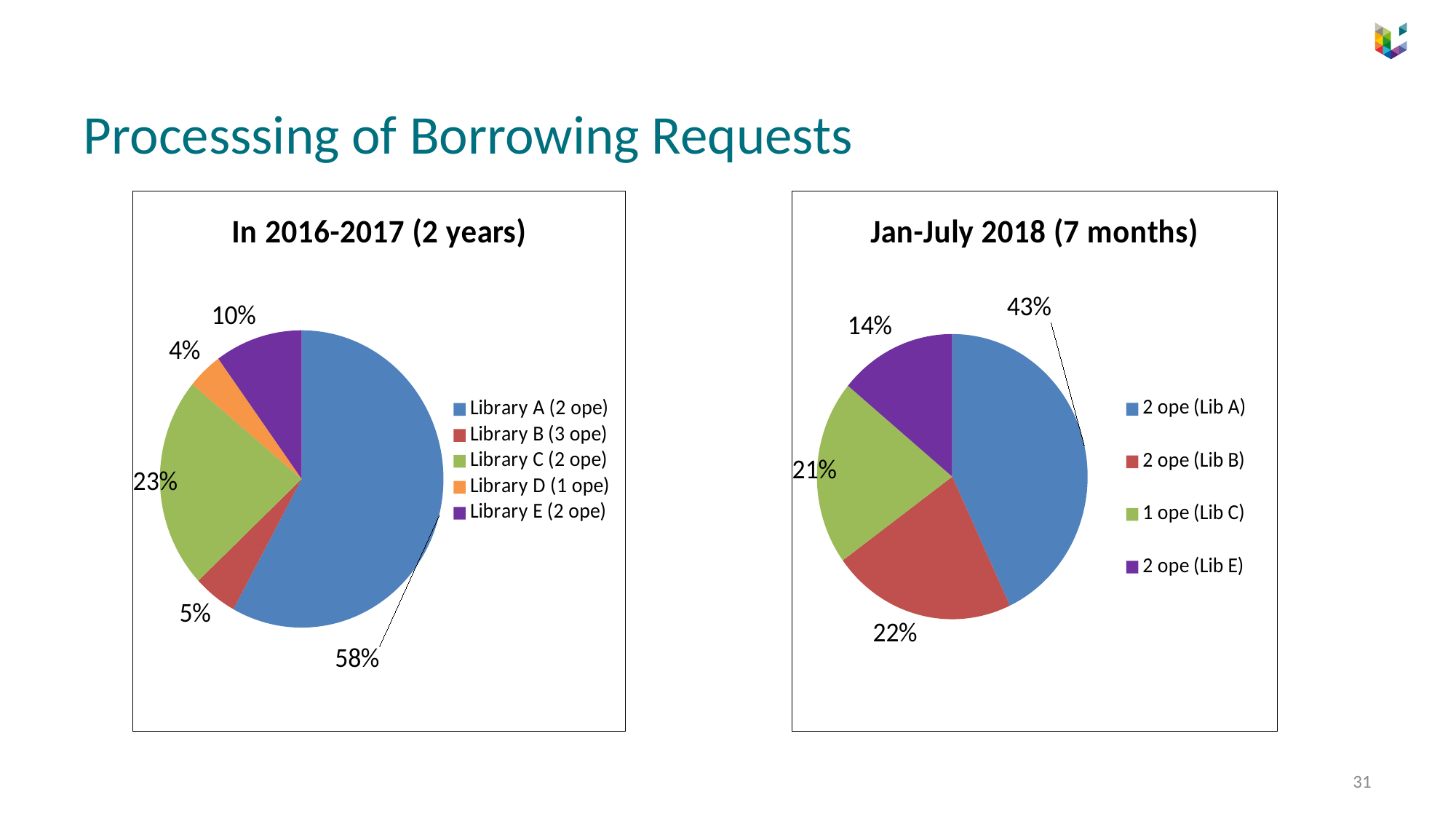
In the 'In 2016-2017 (2 years)' chart, how many slices does the pie have? 5 In the 'In 2016-2017 (2 years)' chart, what colour is the slice for Library D (1 ope)? Orange In the 'Jan-July 2018 (7 months)' chart, which is larger, the share for 2 ope (Lib B) or the share for 2 ope (Lib E)? 2 ope (Lib B) In the 'In 2016-2017 (2 years)' chart, what share does Library A (2 ope) have? 58% In the 'In 2016-2017 (2 years)' chart, which library has the largest slice? Library A (2 ope) In the 'Jan-July 2018 (7 months)' chart, how many categories does the legend list? 4 In the 'In 2016-2017 (2 years)' chart, what share does Library C (2 ope) have? 23% In the 'Jan-July 2018 (7 months)' chart, what share does 2 ope (Lib A) have? 43% In the 'In 2016-2017 (2 years)' chart, which library has the smallest slice? Library D (1 ope) In the 'In 2016-2017 (2 years)' chart, what is the difference between the shares of Library E (2 ope) and Library B (3 ope)? 5% What type of chart is shown on the right side of the slide? Pie chart